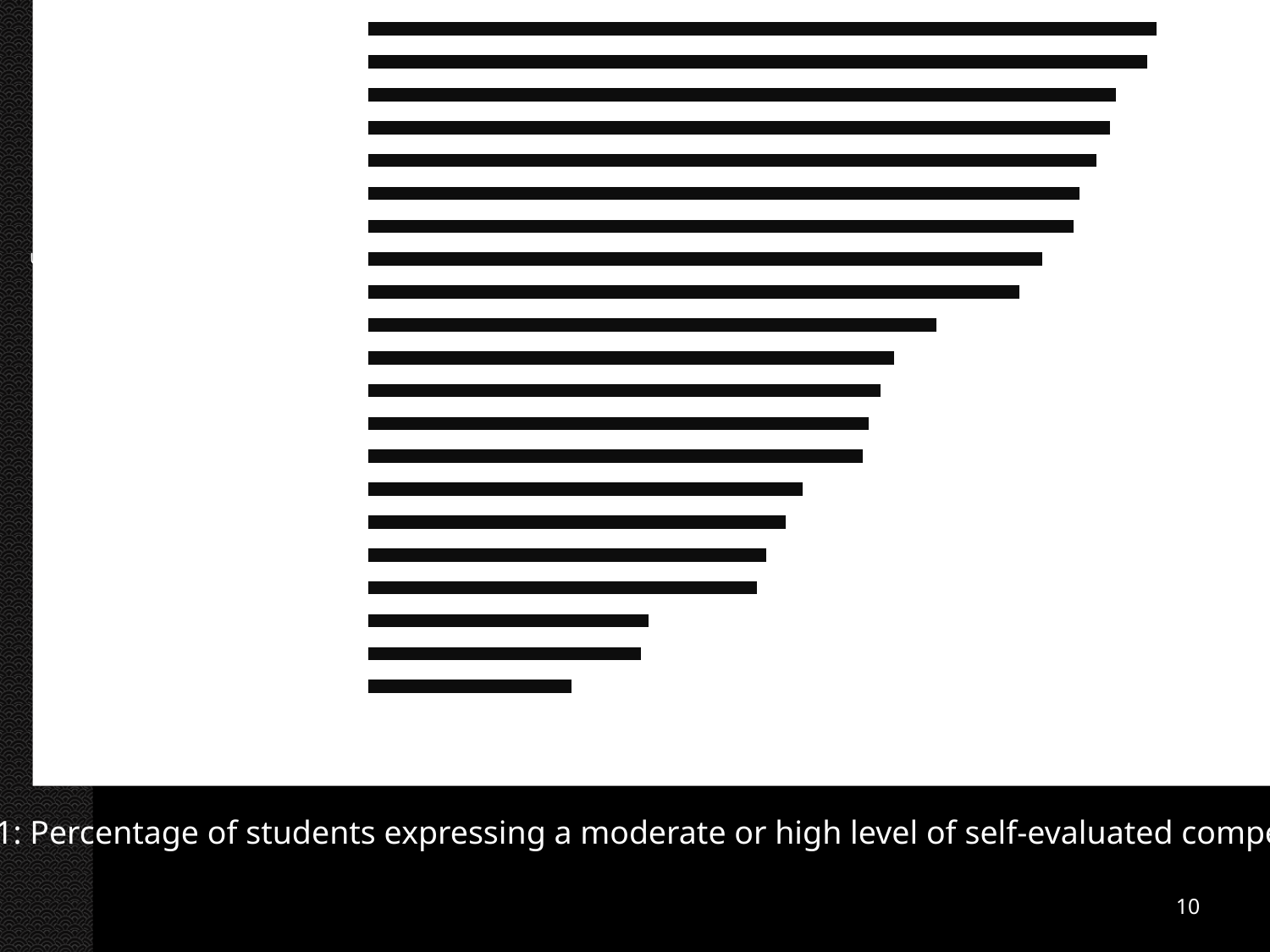
What kind of chart is shown on the slide? bar chart Reading the chart from top to bottom, do the bar lengths increase or decrease? decrease Which bar in the chart is the longest, the topmost or the bottommost? the topmost Which bar in the chart is the shortest, the topmost or the bottommost? the bottommost Is the second bar from the top longer or shorter than the second bar from the bottom? longer Are the bars in the chart drawn horizontally or vertically? horizontally How many bars does the chart contain? 21 What colour are the bars in the chart? black